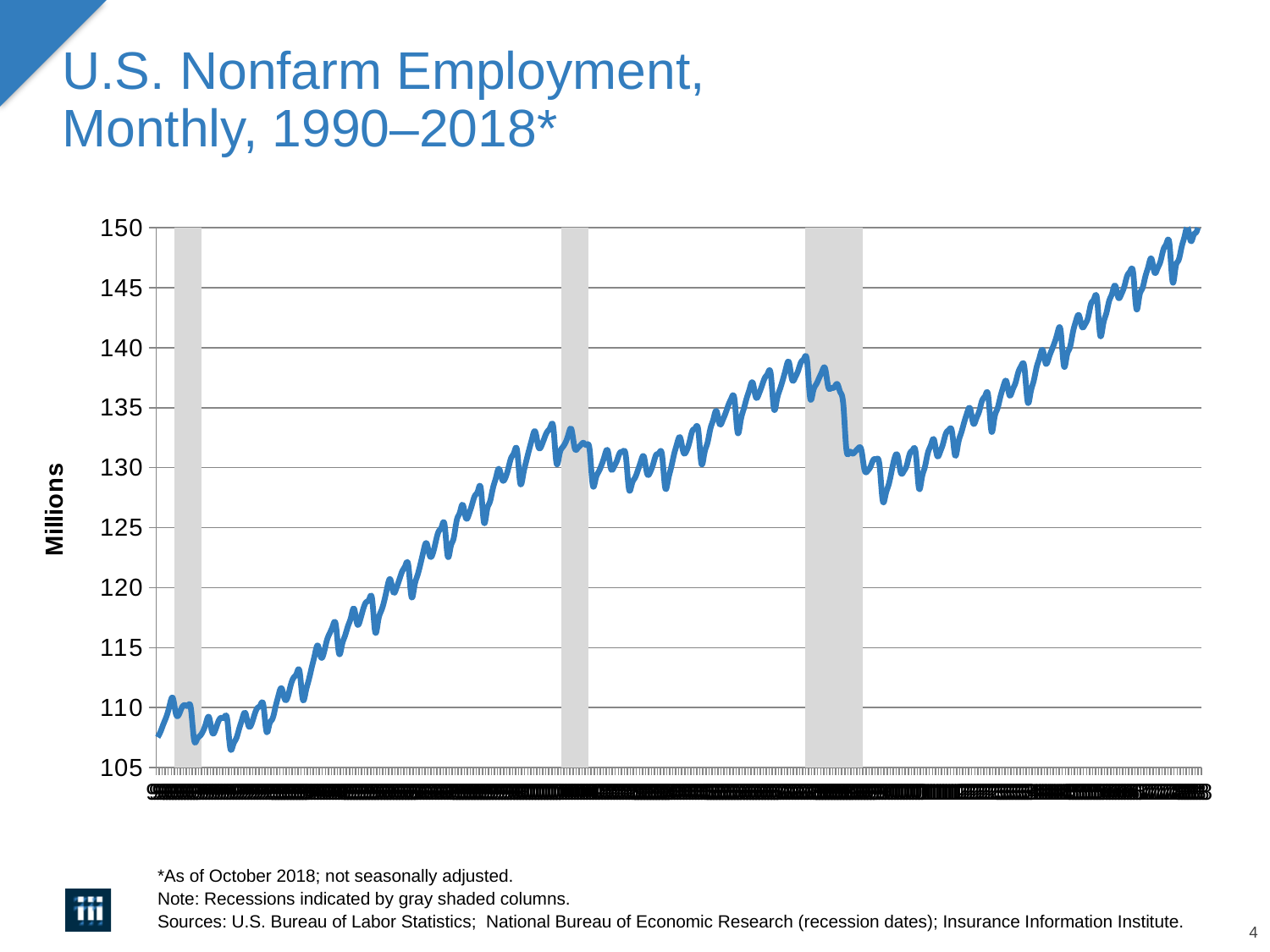
Is the highest value on the line greater or less than 145? greater Is the value at the start of the series (1990) greater or less than 115? less How many gray shaded columns (recessions) are shown on the chart? 3 Is the lowest value reached after the rightmost gray shaded column greater or less than 130? less Over the whole period from 1990 to 2018, does nonfarm employment generally rise or fall? rise Between the first and second gray shaded columns, does the line generally rise or fall? rise What is the title of the chart? U.S. Nonfarm Employment, Monthly, 1990–2018* Which is higher, the value at the start of the series or the value at the end of the series? the end of the series What kind of chart is shown on the slide? line chart During the rightmost gray shaded column, does the line rise or fall? fall